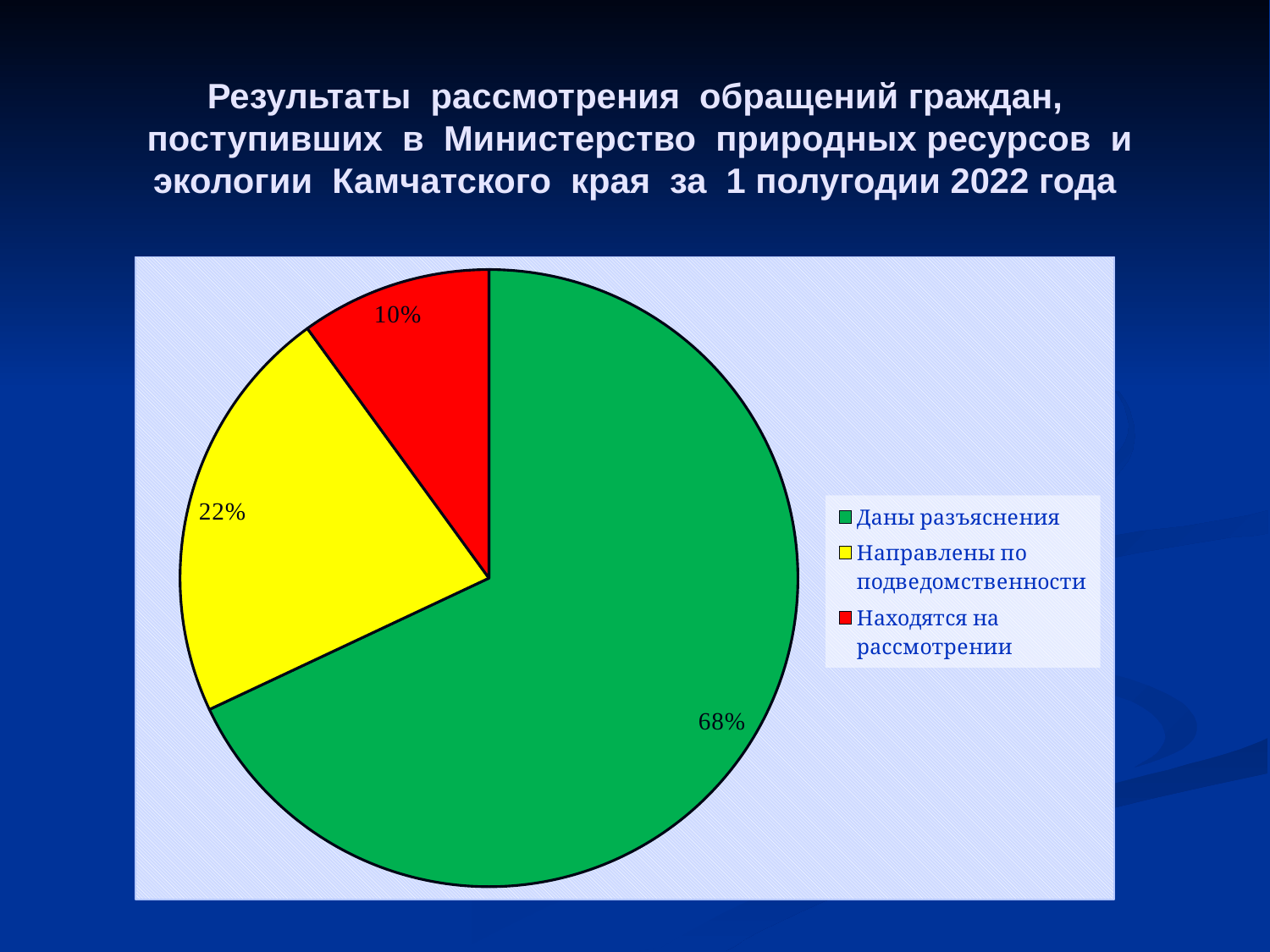
What is the difference in percentage points between "Направлены по подведомственности" and "Находятся на рассмотрении"? 12 Which is larger: the slice for "Направлены по подведомственности" or the slice for "Находятся на рассмотрении"? Направлены по подведомственности What kind of chart is shown on the slide? Pie chart Which category has the largest slice of the pie? Даны разъяснения What colour is the slice for "Находятся на рассмотрении"? Red What share of the pie does "Находятся на рассмотрении" represent? 10% Which category has the smallest slice of the pie? Находятся на рассмотрении How many entries does the legend list? 3 How many slices does the pie chart have? 3 What is the difference in percentage points between "Даны разъяснения" and "Направлены по подведомственности"? 46 What share of the pie does "Направлены по подведомственности" represent? 22% What share of the pie does "Даны разъяснения" represent? 68%